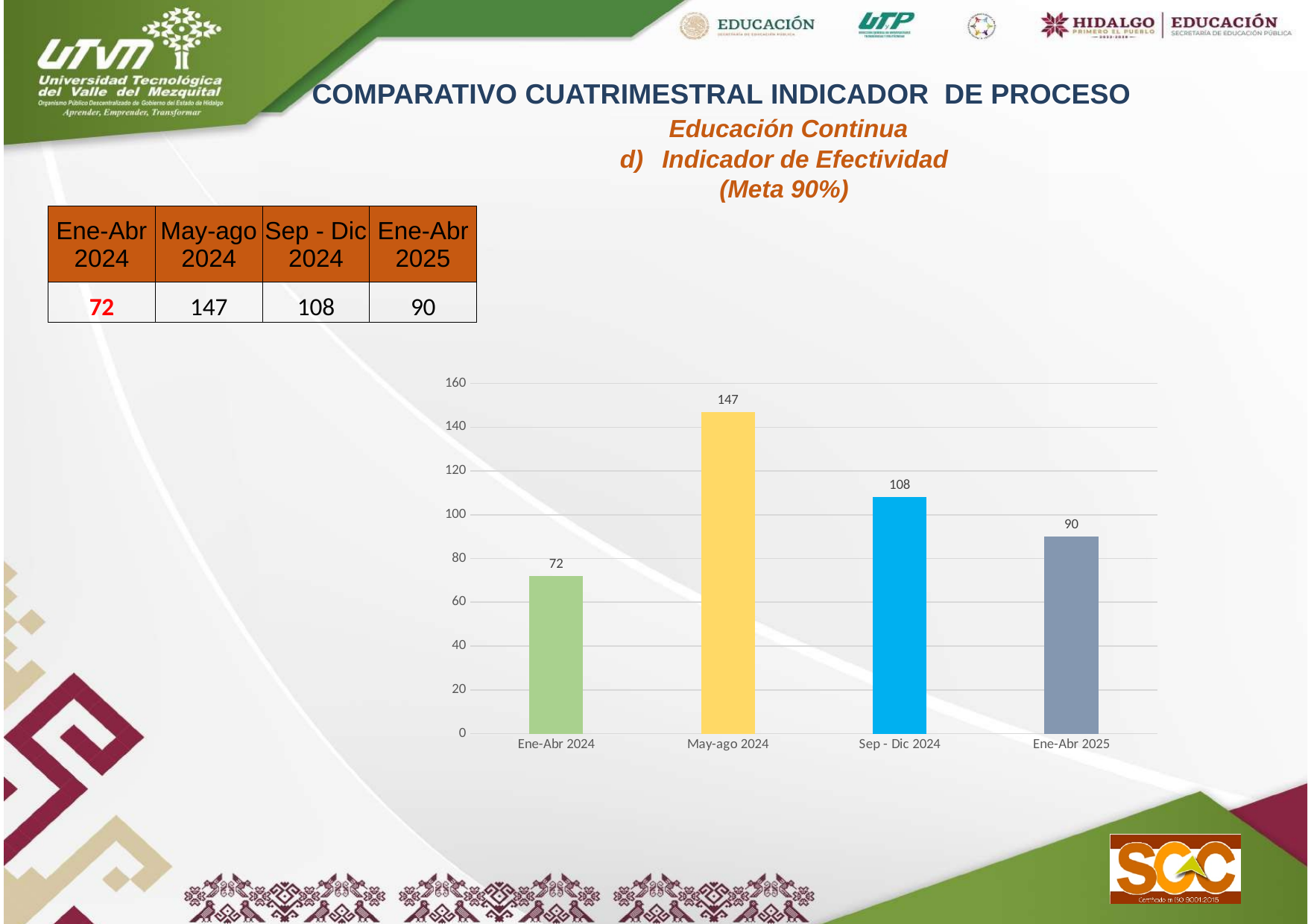
How many periods are shown on the x axis of the chart? 4 What is the difference between the values for Sep - Dic 2024 and Ene-Abr 2025? 18 What is the value for Sep - Dic 2024? 108 Which period has the lowest value? Ene-Abr 2024 Which period has the highest value? May-ago 2024 What is the difference between the values for May-ago 2024 and Ene-Abr 2024? 75 What is the highest value shown on the vertical axis of the chart? 160 What kind of chart is shown on the slide? bar chart What is the value for May-ago 2024? 147 Which is larger, the value for Sep - Dic 2024 or the value for Ene-Abr 2025? Sep - Dic 2024 What is the value for Ene-Abr 2025? 90 Is the value for Ene-Abr 2024 greater or less than 80? less